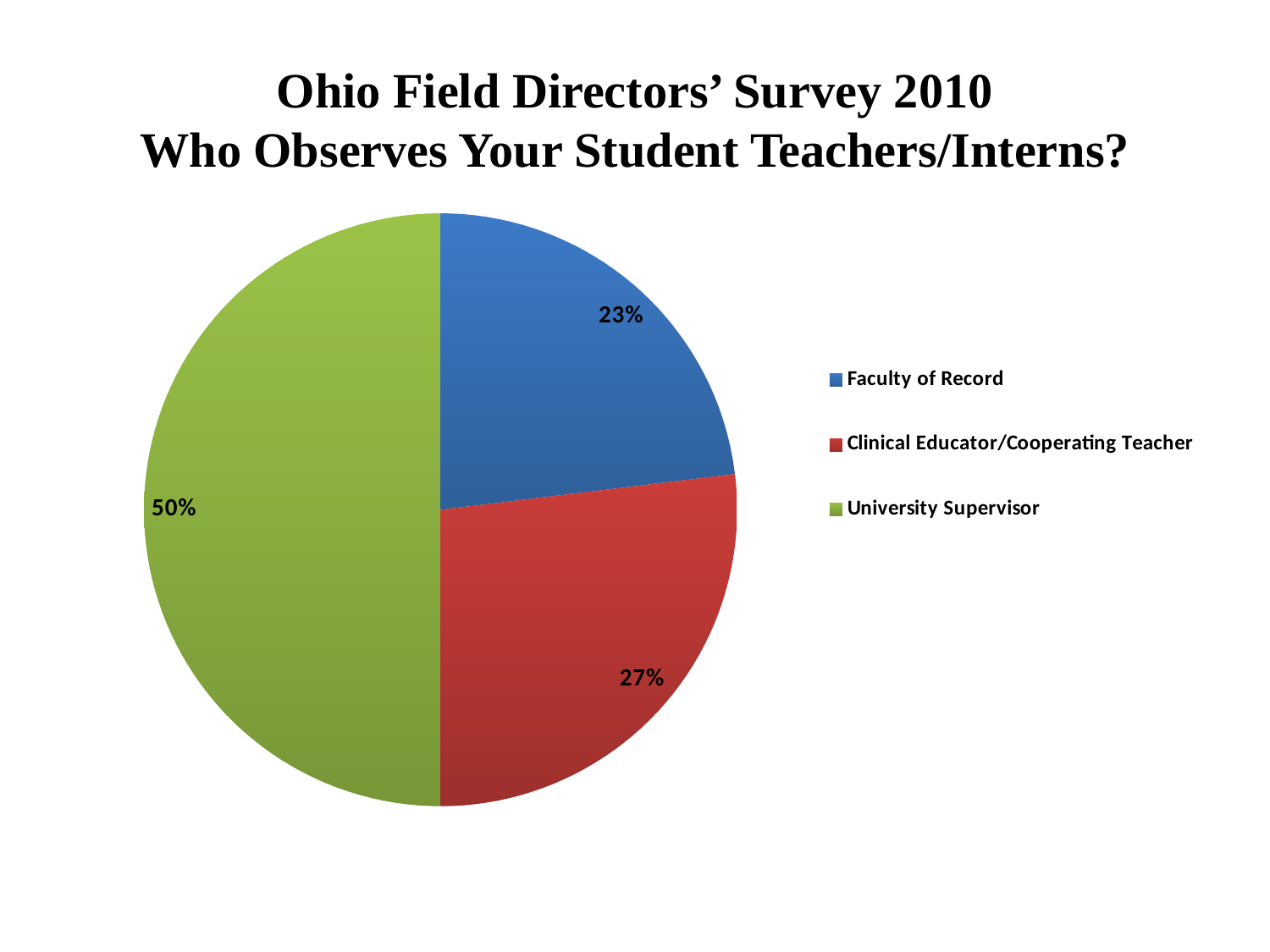
Which category has the largest share of the pie? University Supervisor What percentage of the pie is Faculty of Record? 23% What is the difference in percentage points between Clinical Educator/Cooperating Teacher and Faculty of Record? 4 What percentage of the pie is University Supervisor? 50% Which is larger, the share for Clinical Educator/Cooperating Teacher or the share for Faculty of Record? Clinical Educator/Cooperating Teacher What colour is the University Supervisor slice? green How many categories does the pie chart have? 3 What percentage of the pie is Clinical Educator/Cooperating Teacher? 27% What is the title of the chart? Ohio Field Directors' Survey 2010 Who Observes Your Student Teachers/Interns? What kind of chart is shown on the slide? pie chart What is the difference in percentage points between University Supervisor and Faculty of Record? 27 Which category has the smallest share of the pie? Faculty of Record